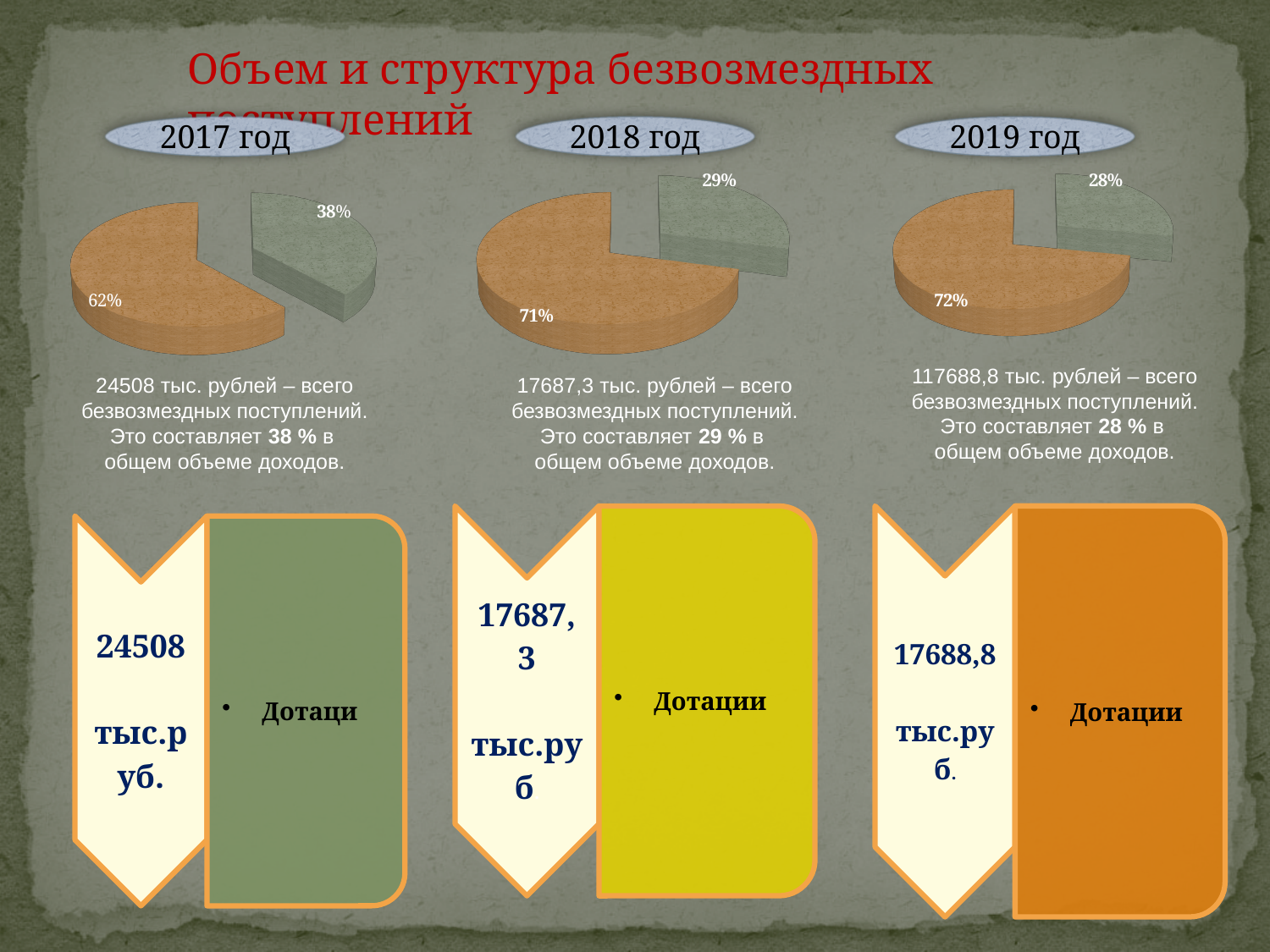
How many slices does each pie chart on the slide have? 2 In the 2019 год pie chart, what percentage is shown on the larger (brown) slice? 72% What is the difference in percentage points between the brown and green slices in the 2017 год pie chart? 24 How many pie charts are on the slide? 3 What kind of chart is shown for each year on the slide? pie chart Which year's pie chart has the largest green slice? 2017 год Which year's pie chart has the smallest green slice? 2019 год In the 2019 год pie chart, what percentage is shown on the smaller (green) slice? 28% In the 2017 год pie chart, what percentage is shown on the smaller (green) slice? 38% In the 2017 год pie chart, what percentage is shown on the larger (brown) slice? 62% In the 2018 год pie chart, what percentage is shown on the larger (brown) slice? 71% In the 2018 год pie chart, what percentage is shown on the smaller (green) slice? 29%